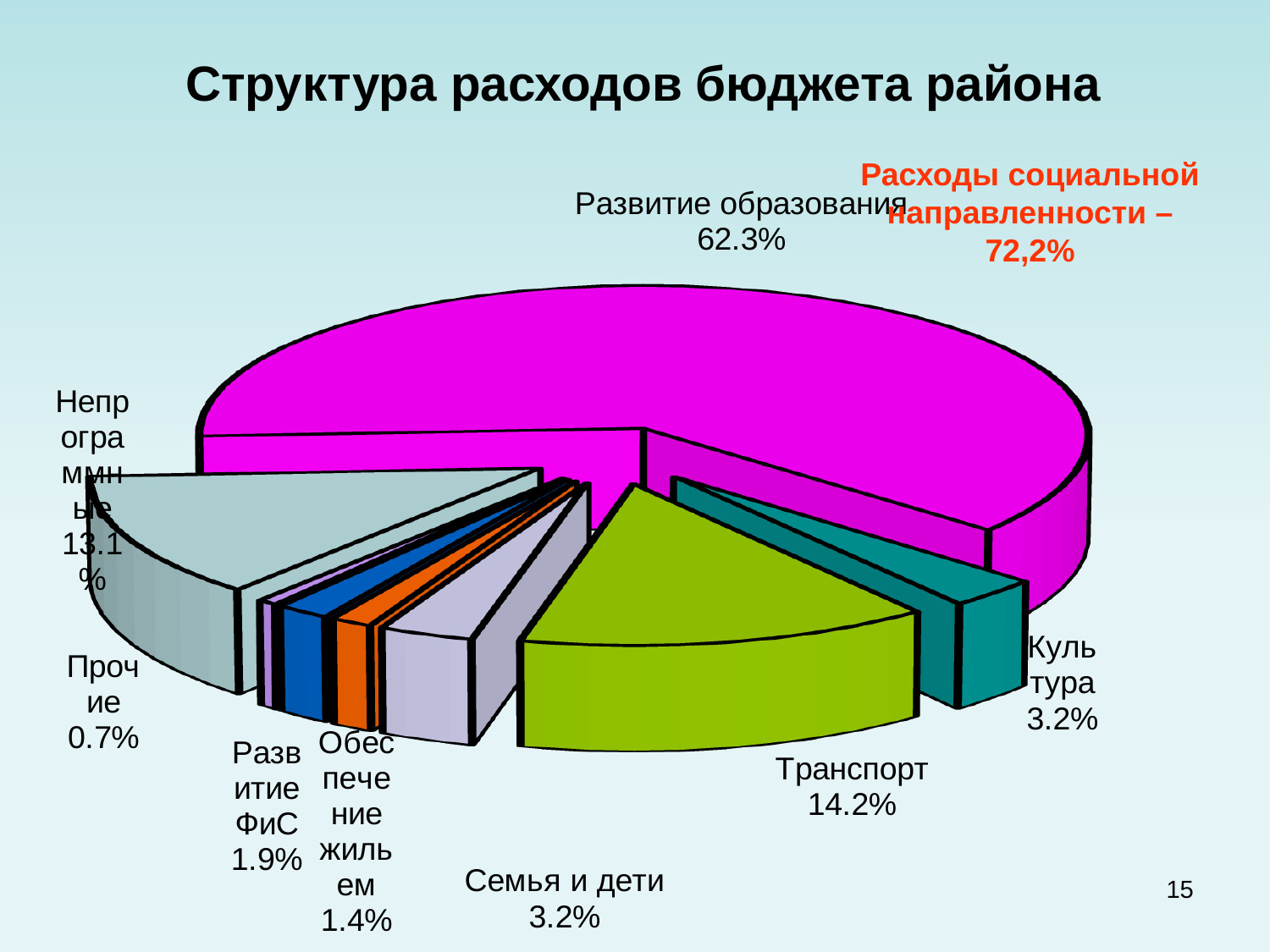
Which category has the smallest share of the pie? Прочие What is the difference between the shares of Транспорт and Непрограммные? 1.1% What is the share for Развитие образования? 62.3% What is the share for Транспорт? 14.2% What kind of chart is shown on the slide? pie chart What is the share for Обеспечение жильем? 1.4% What is the title of the chart on the slide? Структура расходов бюджета района Which is larger, the share for Транспорт or the share for Семья и дети? Транспорт How many slices does the pie chart have? 8 Which category has the largest share of the pie? Развитие образования What is the share for Развитие ФиС? 1.9% What is the share for Культура? 3.2%